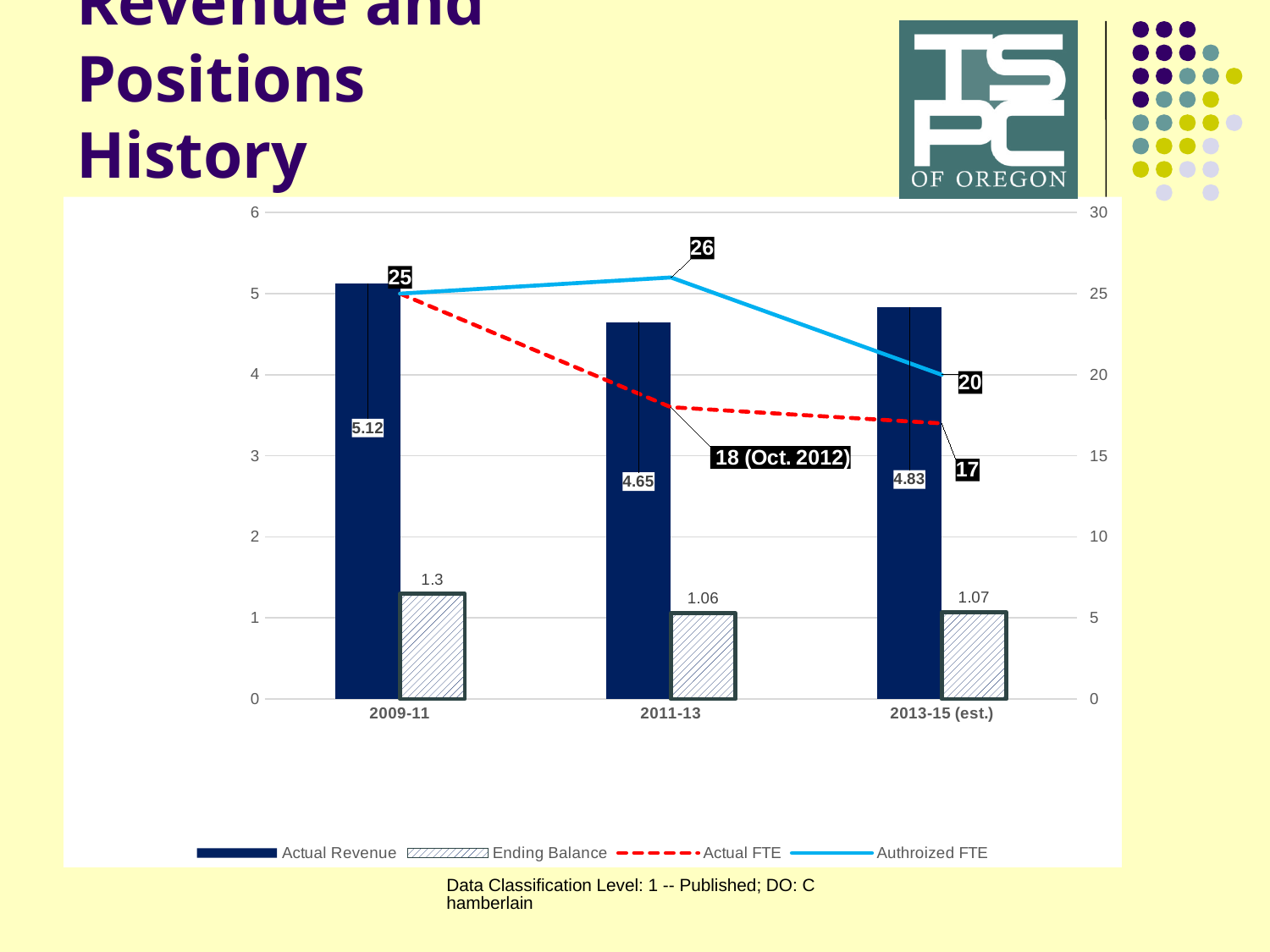
What is the Actual FTE data label shown for 2011-13? 18 (Oct. 2012) What is the Actual Revenue value for 2009-11? 5.12 How many series does the legend list? 4 What is the difference between Actual Revenue in 2009-11 and 2011-13? 0.47 Which series is drawn as a red dashed line? Actual FTE Which period has the lowest Ending Balance? 2011-13 Does the Actual FTE line rise or fall from 2009-11 to 2013-15 (est.)? fall Which is larger, the Authroized FTE for 2011-13 or for 2013-15 (est.)? 2011-13 What is the Authroized FTE value for 2013-15 (est.)? 20 How many periods are shown on the x axis? 3 What is the Ending Balance value for 2011-13? 1.06 Which period has the highest Actual Revenue? 2009-11